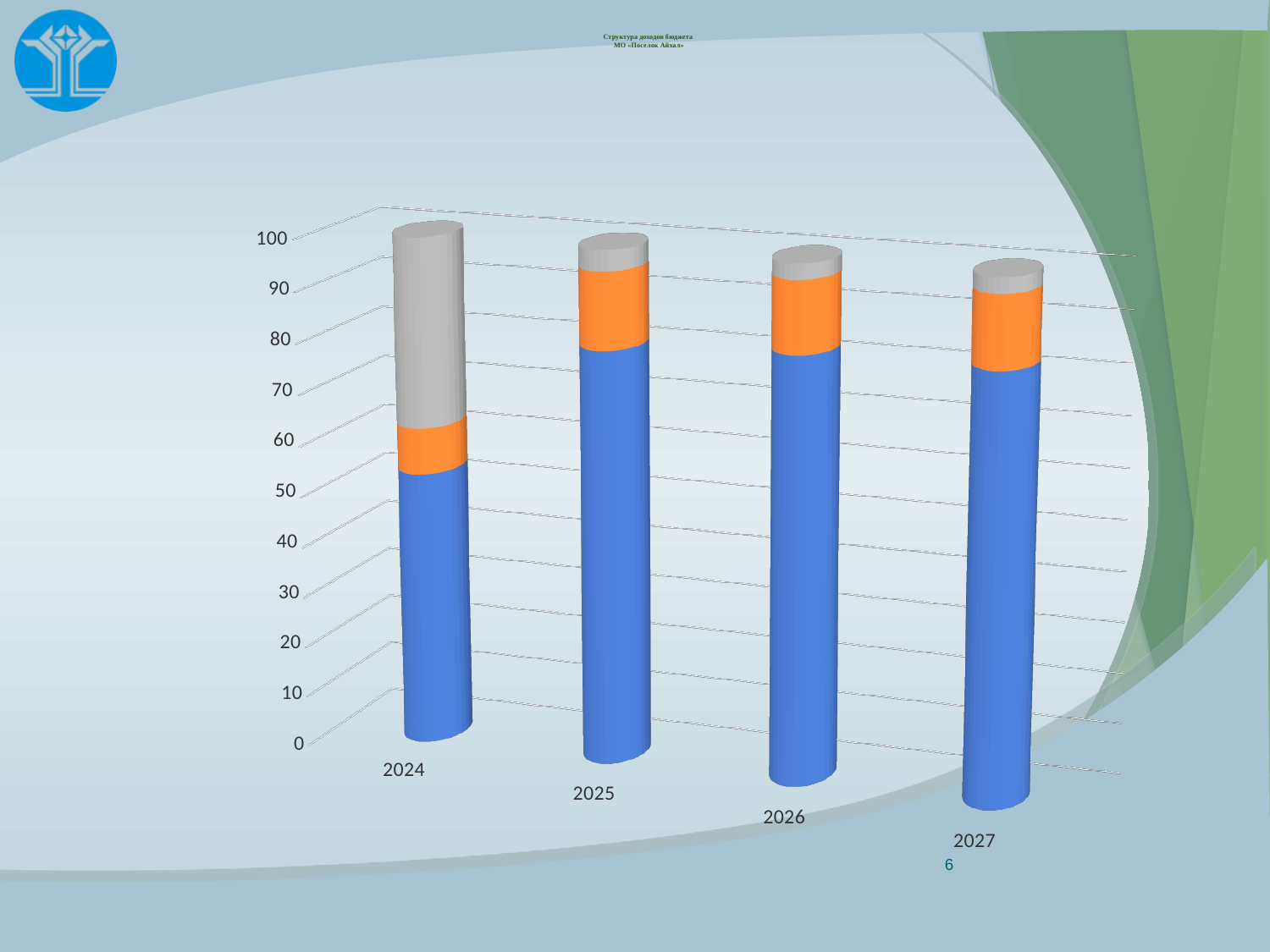
What kind of chart is shown on the slide? Stacked bar chart Is the top of the blue segment for 2025 greater or less than 60? greater How many years (categories) are shown along the x axis of the chart? 4 Which is larger: the grey segment for 2024 or the grey segment for 2025? 2024 What is the highest value shown on the vertical axis of the chart? 100 How many differently coloured segments are stacked in each bar of the chart? 3 Which year has the largest grey segment in the chart? 2024 Is the top of the blue segment for 2024 greater or less than 70? less What is the first year shown on the x axis of the chart? 2024 Which year has the smallest blue segment in the chart? 2024 Is the top of the blue segment for 2024 greater or less than 40? greater Which is larger: the blue segment for 2025 or the blue segment for 2024? 2025